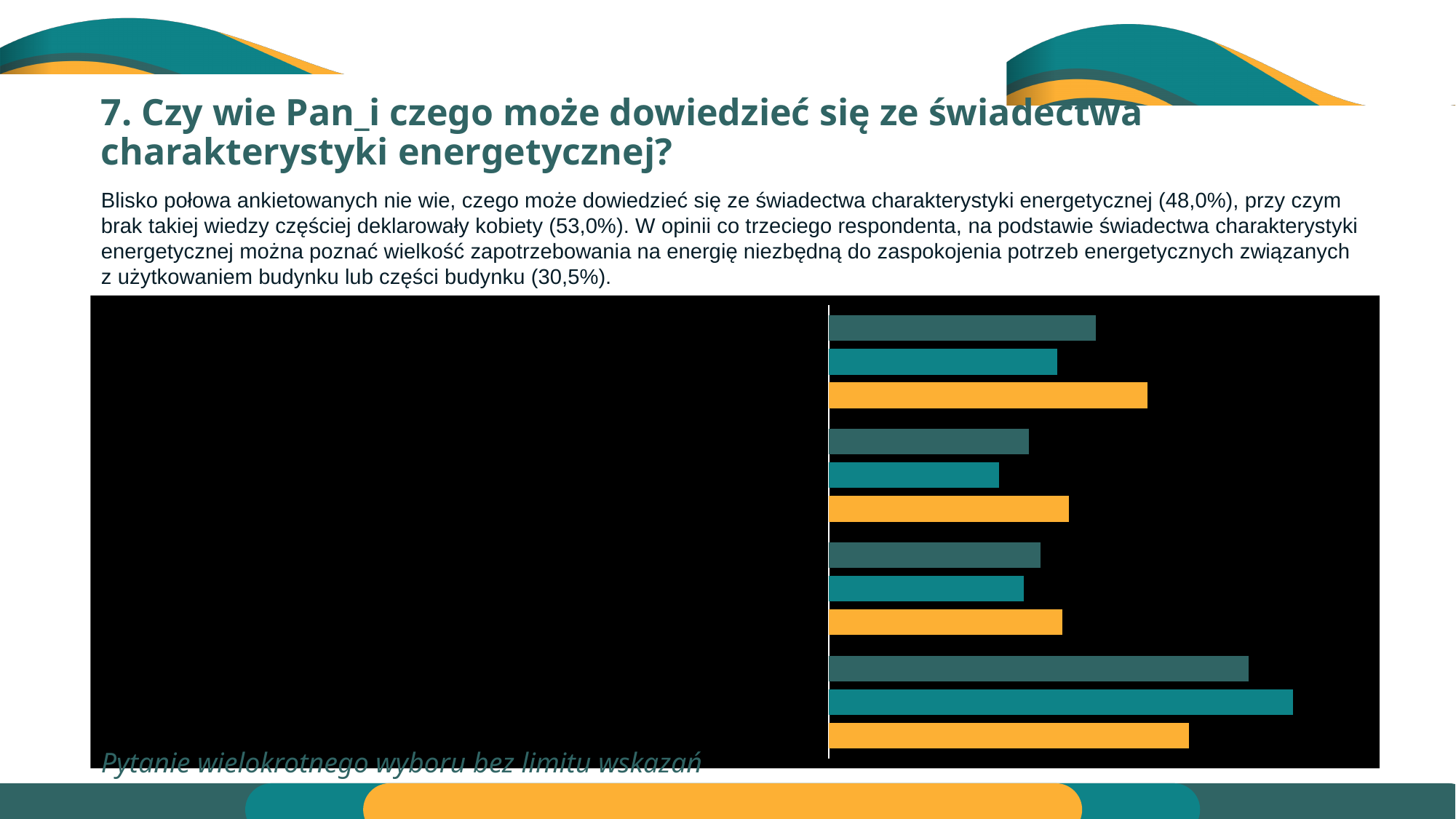
How many different bar colours are used in the chart? 3 How many bars in total are plotted in the chart? 12 Are the bars in the chart drawn horizontally or vertically? horizontally What kind of chart is shown on the slide? bar chart Which group of bars, counting from the top, contains the longest bar in the chart? the fourth (bottom) group Within the top group of bars, which bar is the longest: the top, middle or bottom one? the bottom one How many bars are there in each group of the chart? 3 Within the bottom group of bars, which bar is the longest: the top, middle or bottom one? the middle one How many groups of bars does the chart contain? 4